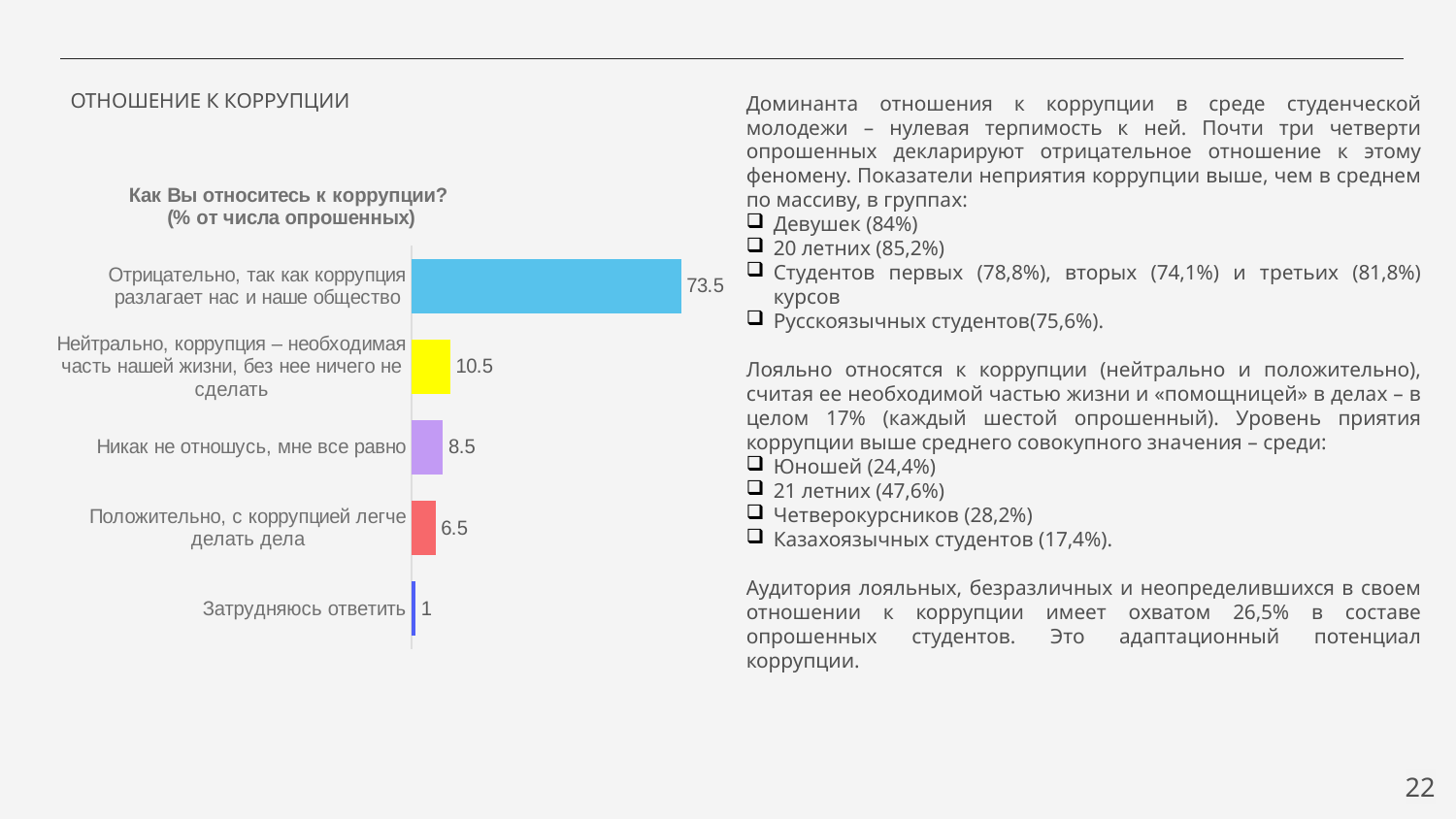
Which is larger: the value for "Никак не отношусь, мне все равно" or for "Положительно, с коррупцией легче делать дела"? Никак не отношусь, мне все равно What is the difference between the values for "Отрицательно, так как коррупция разлагает нас и наше общество" and "Нейтрально, коррупция – необходимая часть нашей жизни, без нее ничего не сделать"? 63 What is the value for "Нейтрально, коррупция – необходимая часть нашей жизни, без нее ничего не сделать"? 10.5 Which category has the lowest value? Затрудняюсь ответить What is the value for "Затрудняюсь ответить"? 1 What is the value for "Отрицательно, так как коррупция разлагает нас и наше общество"? 73.5 What is the value for "Положительно, с коррупцией легче делать дела"? 6.5 What kind of chart is shown on the slide? Bar chart What is the value for "Никак не отношусь, мне все равно"? 8.5 Which category has the highest value? Отрицательно, так как коррупция разлагает нас и наше общество How many categories are shown in the chart? 5 What is the title of the chart? Как Вы относитесь к коррупции? (% от числа опрошенных)